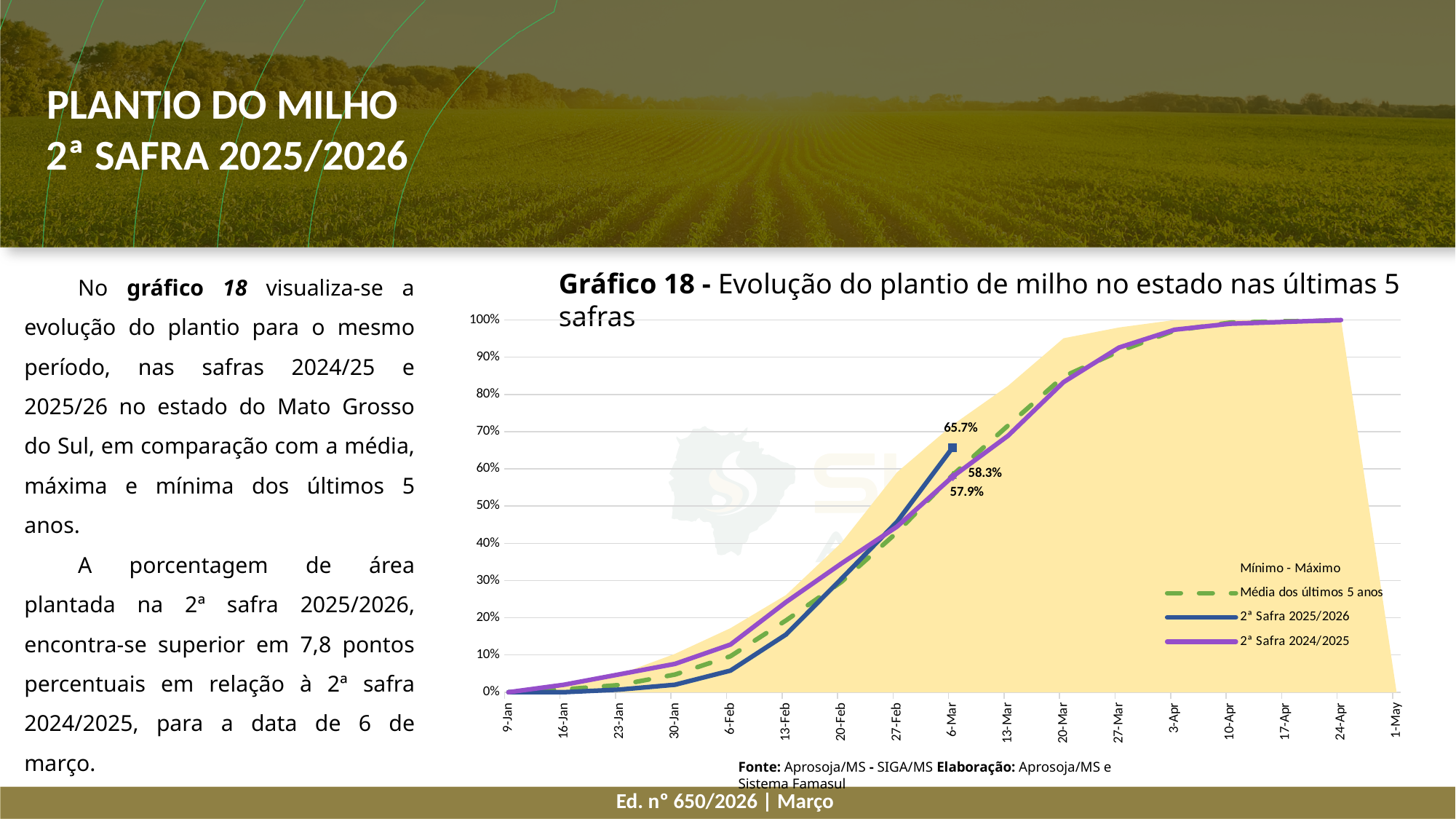
On 6-Mar, which is larger: the 2ª Safra 2025/2026 value or the 2ª Safra 2024/2025 value? 2ª Safra 2025/2026 How many entries does the legend list? 4 What is the value labelled for 2ª Safra 2025/2026 on 6-Mar? 65.7% What type of chart is Gráfico 18? combination area and line chart What is the last date on the x axis for which the 2ª Safra 2025/2026 line has data? 6-Mar What is the value labelled for 2ª Safra 2024/2025 on 6-Mar? 57.9% Which legend entry is drawn as a dashed green line? Média dos últimos 5 anos Do the plotted lines rise or fall from 9-Jan to 24-Apr? rise Is the 2ª Safra 2025/2026 value on 13-Feb greater or less than 20%? less Is the 2ª Safra 2024/2025 value on 20-Mar greater or less than 80%? greater How many dates are shown on the x axis? 17 What is the difference in percentage points between the 2ª Safra 2025/2026 value (65.7%) and the 2ª Safra 2024/2025 value (57.9%) on 6-Mar? 7.8 percentage points